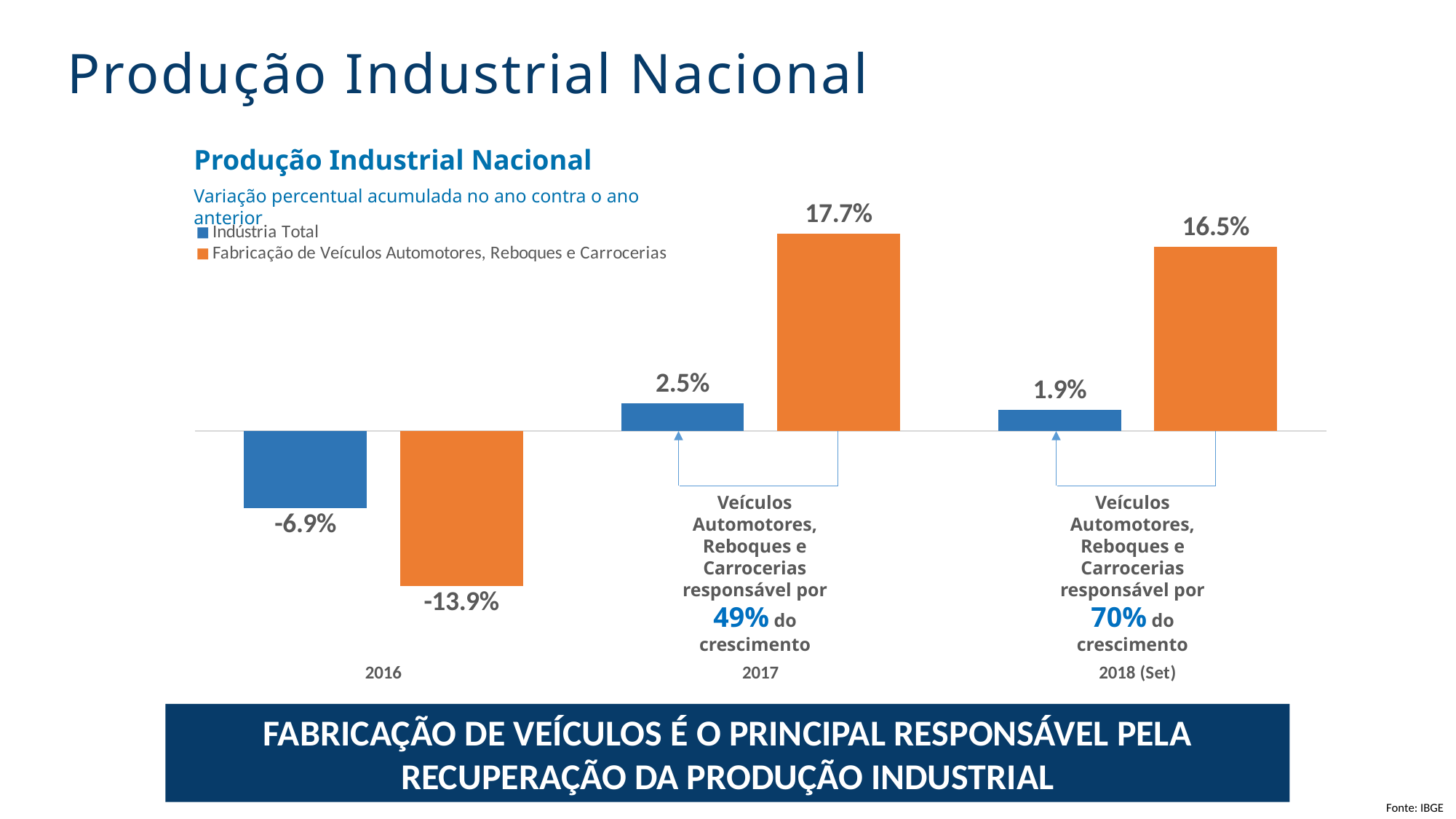
Which is larger in 2018 (Set): Indústria Total or Fabricação de Veículos Automotores, Reboques e Carrocerias? Fabricação de Veículos Automotores, Reboques e Carrocerias In which year is the Indústria Total value lowest? 2016 What is the value for Fabricação de Veículos Automotores, Reboques e Carrocerias in 2016? -13.9% What kind of chart is shown? Bar chart What is the value for Indústria Total in 2016? -6.9% What is the value for Indústria Total in 2018 (Set)? 1.9% What is the value for Fabricação de Veículos Automotores, Reboques e Carrocerias in 2017? 17.7% In which year does Fabricação de Veículos Automotores, Reboques e Carrocerias reach its highest value? 2017 How many series does the legend list? 2 How many years are shown on the x axis? 3 What is the title of the chart? Produção Industrial Nacional What is the difference between the Fabricação de Veículos Automotores, Reboques e Carrocerias value and the Indústria Total value in 2017? 15.2%